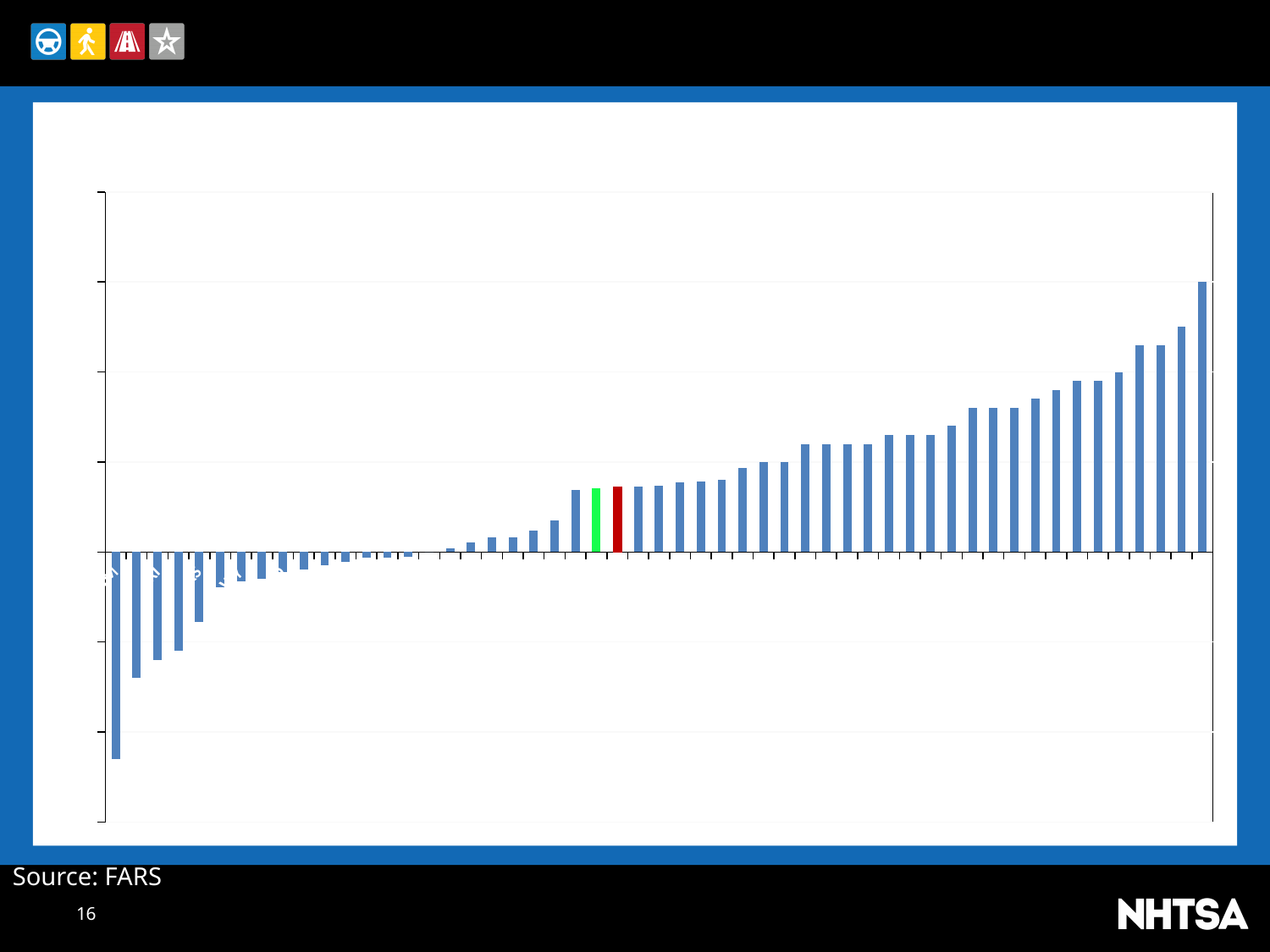
Are the leftmost bars in the chart positive or negative (above or below the zero line)? negative (below the zero line) What kind of chart is shown on the slide? bar chart Do the bar values rise or fall moving from left to right along the x axis? rise Apart from blue, what two colours are used to highlight individual bars in the chart? green and red What source is cited below the chart? FARS